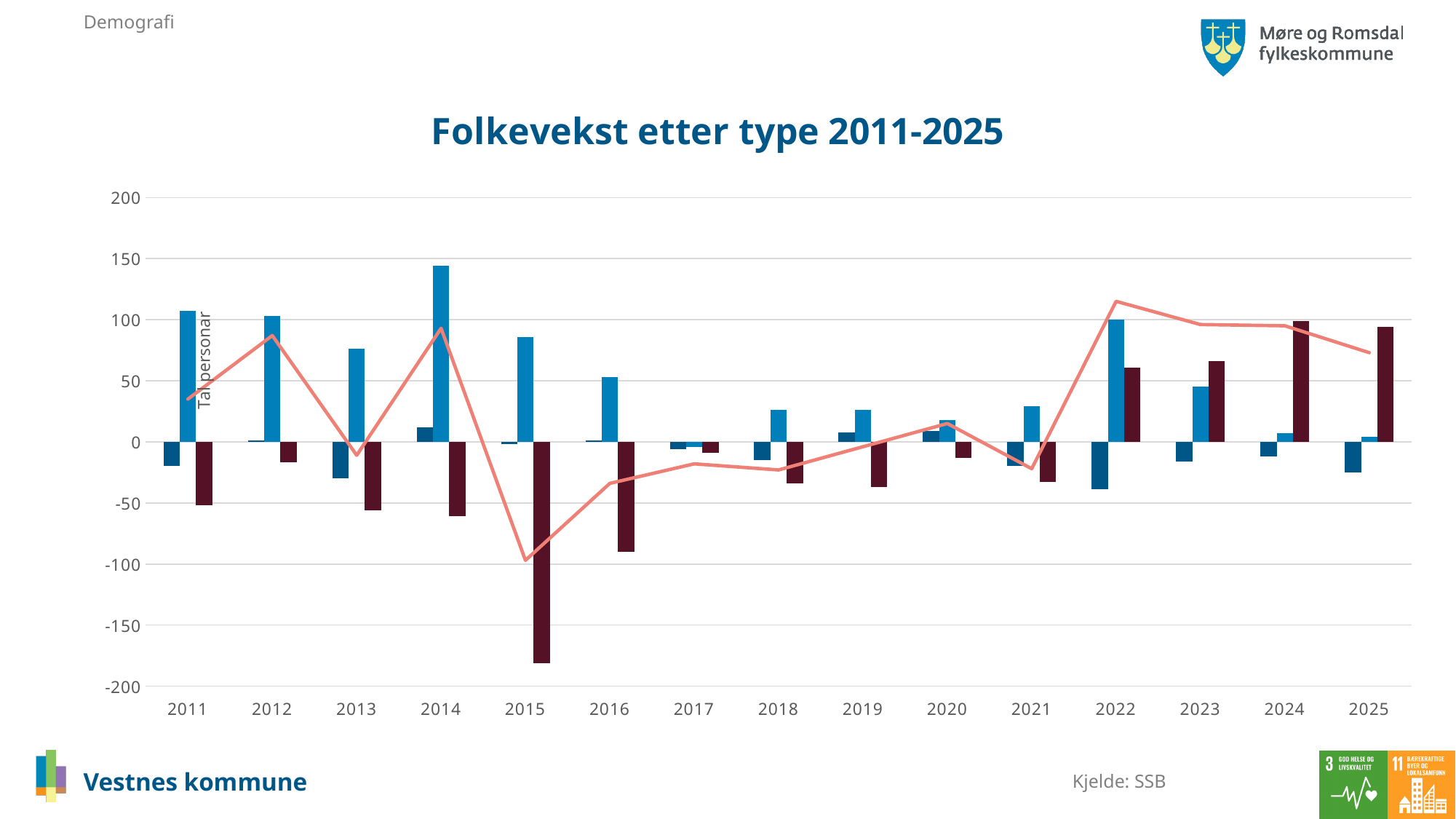
How many years are shown along the x axis of the chart? 15 In which year does the line reach its lowest point? 2015 Is the value of the line in 2022 greater or less than 100? greater In which year is the light blue bar the tallest? 2014 What is the title of the chart? Folkevekst etter type 2011-2025 Which year has the larger light blue bar, 2012 or 2014? 2014 What kind of chart is shown on the slide? Combined bar and line chart Is the value of the dark red bar in 2015 greater or less than -150? less In which year does the line reach its highest point? 2022 What is the label on the vertical axis of the chart? Tal personar Is the value of the light blue bar in 2014 greater or less than 100? greater In which year does the dark red bar reach its lowest value? 2015